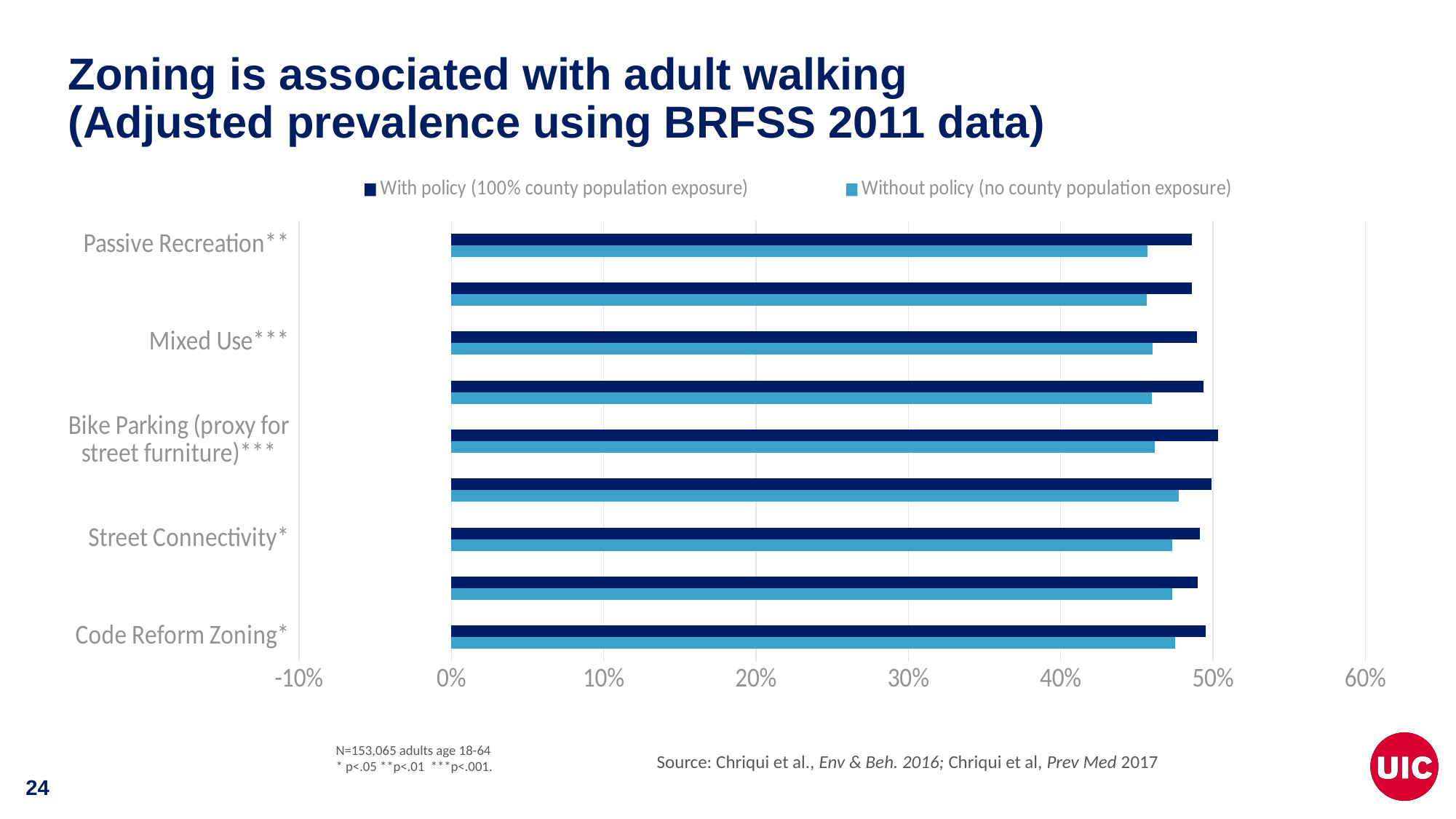
For Mixed Use, which series has the larger value: With policy or Without policy? With policy How many series does the legend list? 2 Is the Without policy value for Passive Recreation greater or less than 50%? less What kind of chart is shown on the slide? Bar chart Is the With policy value for Code Reform Zoning greater or less than 40%? greater What are the two series named in the legend? With policy (100% county population exposure) and Without policy (no county population exposure) For Passive Recreation, which series has the larger value: With policy or Without policy? With policy Is the Without policy value for Mixed Use greater or less than 50%? less For Street Connectivity, which series has the larger value: With policy or Without policy? With policy